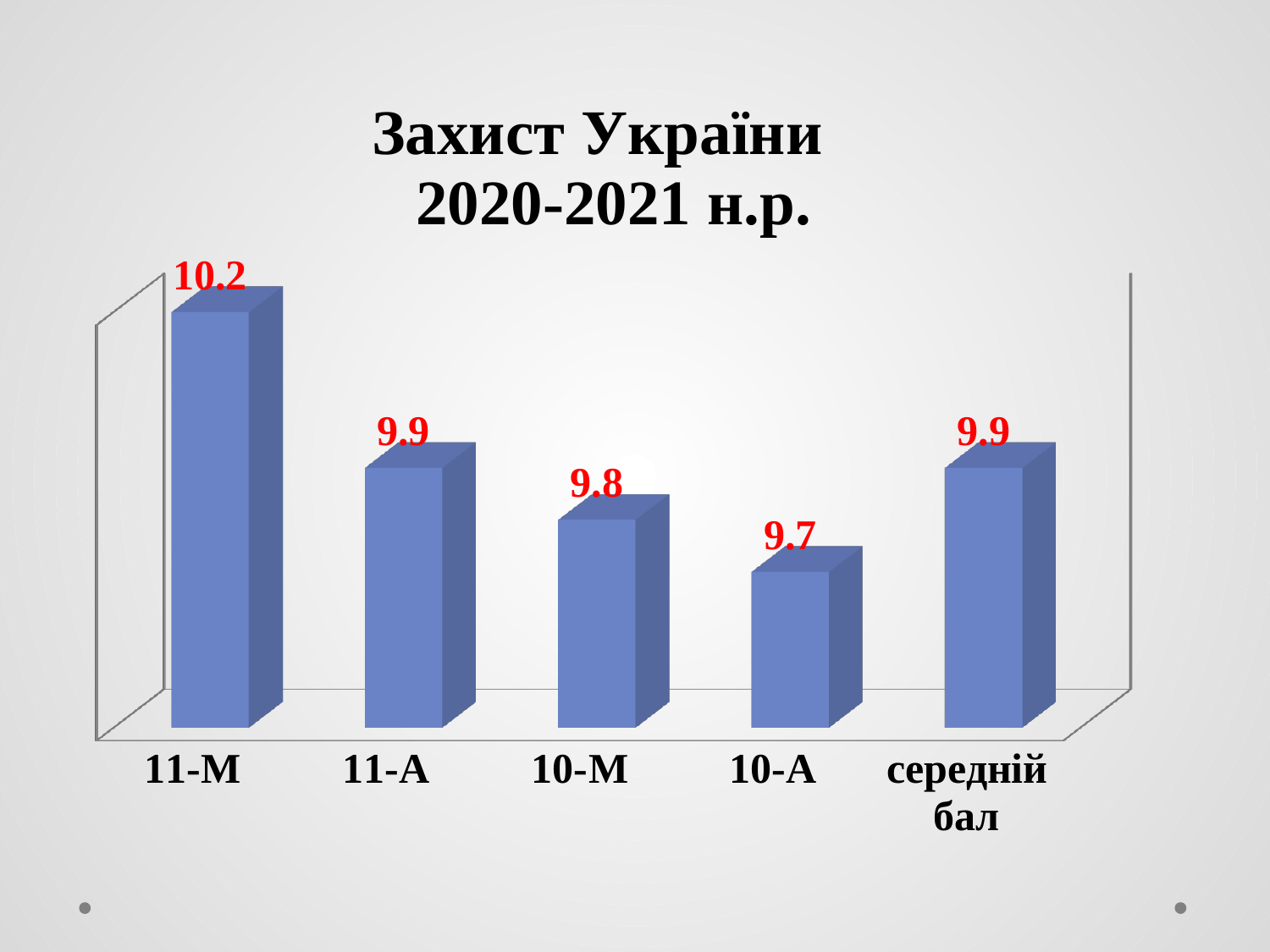
Which category has the highest value? 11-М What is the title of the chart? Захист України 2020-2021 н.р. Which category has the lowest value? 10-А What is the difference between the values for 11-М and 10-А? 0.5 What is the value for 11-М? 10.2 What is the value for 10-А? 9.7 Which is larger, the value for 11-А or the value for 10-А? 11-А What kind of chart is shown on the slide? bar chart What is the value for 10-М? 9.8 How many categories are shown on the chart? 5 What is the difference between the values for 11-А and 10-М? 0.1 What is the value for середній бал? 9.9